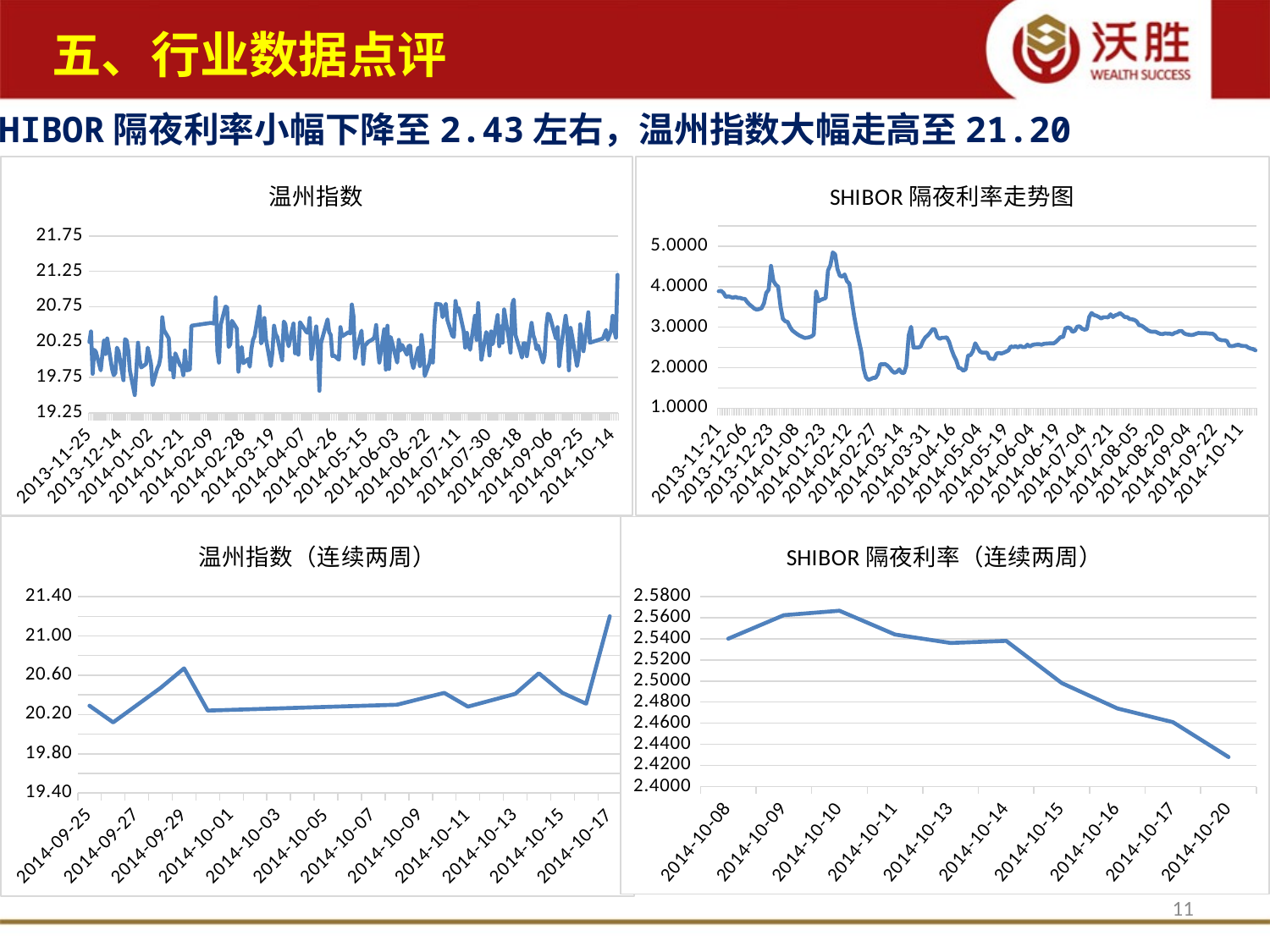
In the bottom-left chart 温州指数（连续两周）, is the value for 2014-10-17 greater or less than 21.00? greater In the bottom-right chart SHIBOR 隔夜利率（连续两周）, which date has the lowest value? 2014-10-20 In the bottom-right chart SHIBOR 隔夜利率（连续两周）, do the values generally rise or fall from 2014-10-10 to 2014-10-20? fall In the bottom-right chart SHIBOR 隔夜利率（连续两周）, which date has the highest value? 2014-10-10 In the bottom-right chart SHIBOR 隔夜利率（连续两周）, is the value for 2014-10-10 greater or less than 2.5400? greater In the top-right chart SHIBOR 隔夜利率走势图, is the peak value around 2014-02-12 greater or less than 4.0000? greater What is the title of the top-left chart on the slide? 温州指数 In the bottom-left chart 温州指数（连续两周）, which date has the highest value? 2014-10-17 What kind of chart is the bottom-right chart titled SHIBOR 隔夜利率（连续两周）? line chart In the bottom-right chart SHIBOR 隔夜利率（连续两周）, how many dates are shown on the x axis? 10